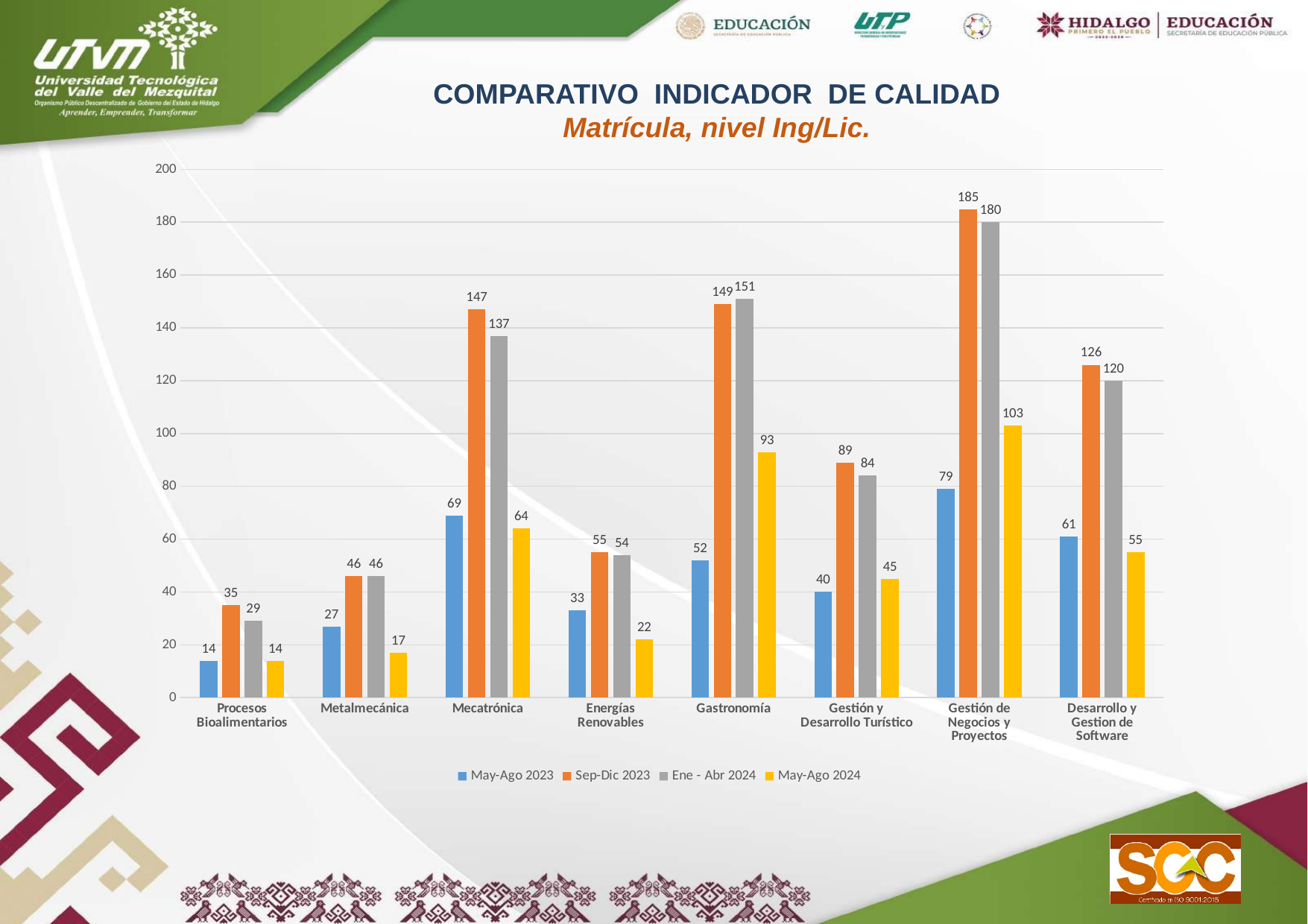
How many categories are shown on the x axis? 8 How many series does the legend list? 4 What kind of chart is shown on the slide? bar chart What is the value for Gastronomía in the May-Ago 2024 series? 93 What is the value for Mecatrónica in the Sep-Dic 2023 series? 147 What is the value for Energías Renovables in the May-Ago 2023 series? 33 What is the difference between the Sep-Dic 2023 and Ene - Abr 2024 values for Mecatrónica? 10 Which category has the highest value in the Sep-Dic 2023 series? Gestión de Negocios y Proyectos Which category has the lowest value in the Ene - Abr 2024 series? Procesos Bioalimentarios Which is larger for Gastronomía: the Sep-Dic 2023 value or the Ene - Abr 2024 value? Ene - Abr 2024 What is the subtitle of the chart shown in orange text? Matrícula, nivel Ing/Lic. Is the May-Ago 2024 value for Gestión de Negocios y Proyectos greater or less than 100? greater